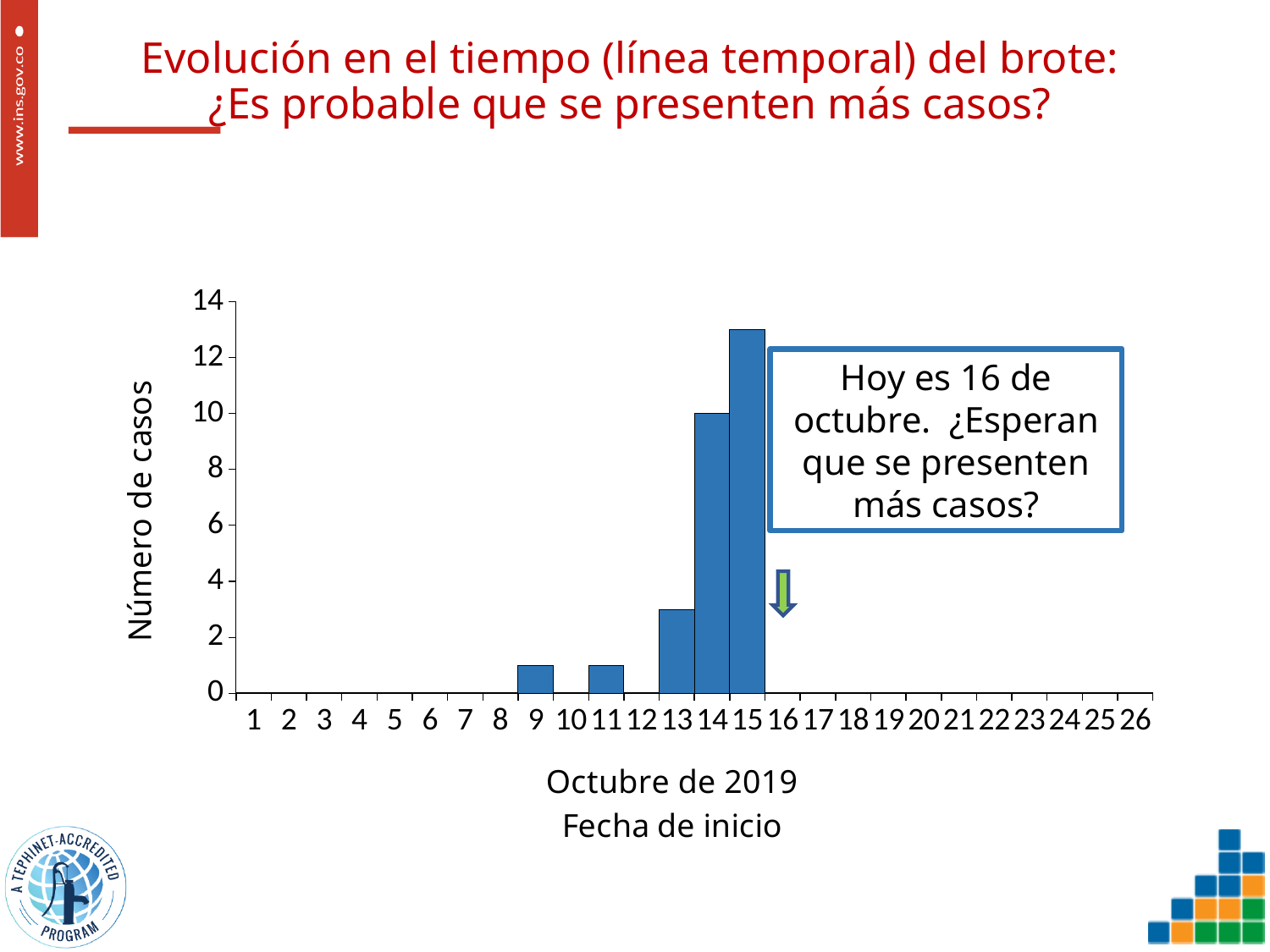
Which date has more cases, October 11 or October 15? 15 How many dates are labelled on the x axis? 26 Is the number of cases for October 9 greater or less than 2? less How many dates have a bar showing at least one case? 5 Is the number of cases for October 13 greater or less than 4? less Which date has more cases, October 13 or October 14? 14 What kind of chart is shown on the slide? bar chart Which date has the highest number of cases? 15 How many cases are shown for October 14? 10 What is the label of the y axis? Número de casos Is the number of cases for October 15 greater or less than 12? greater Do the number of cases rise or fall from October 13 to October 15? rise